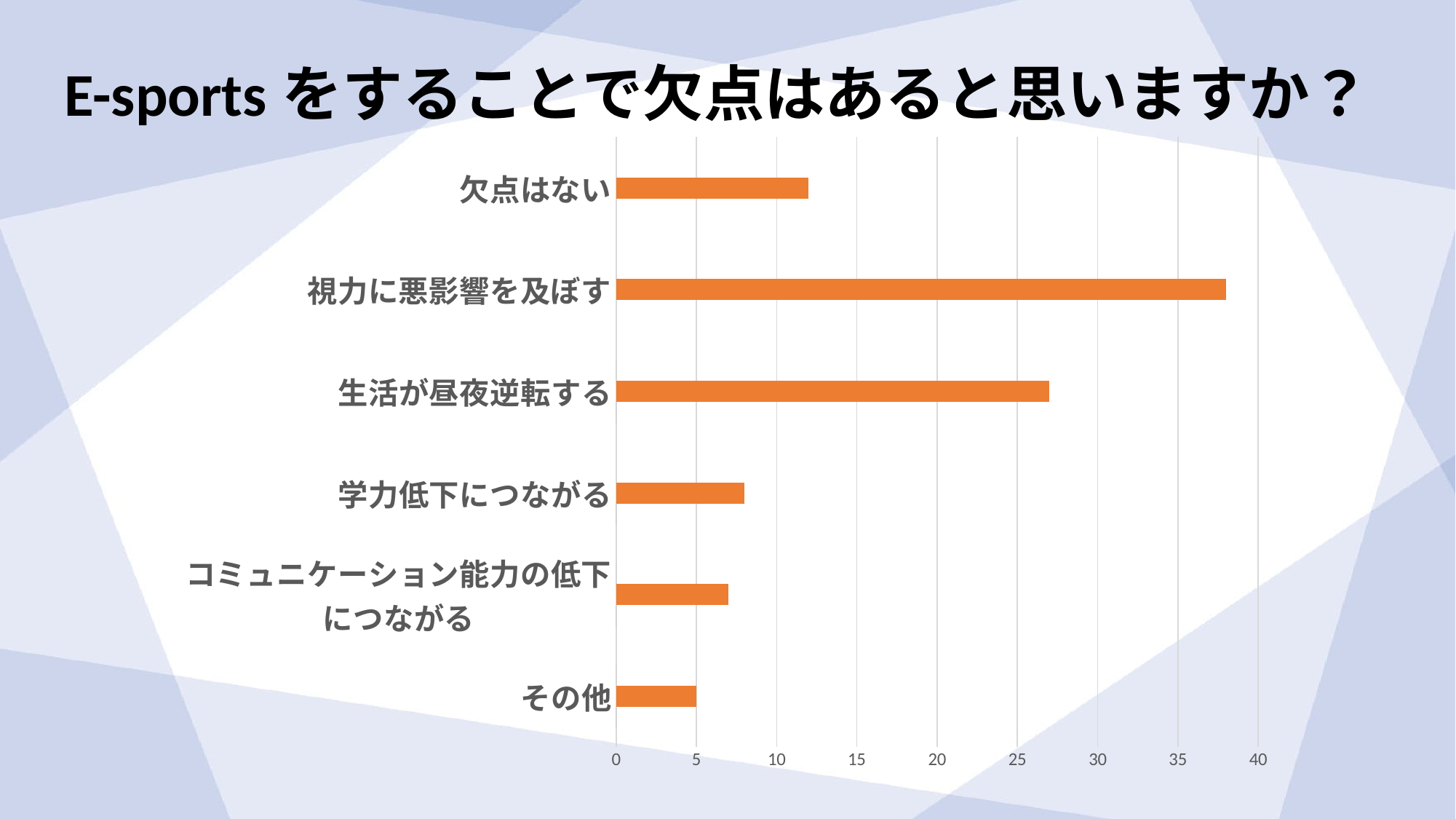
What kind of chart is shown on the slide? bar chart What is the title of the slide? E-sports をすることで欠点はあると思いますか？ Which category has the highest value? 視力に悪影響を及ぼす Which category has the lowest value? その他 Is the value for 欠点はない greater or less than 10? greater Is the value for 生活が昼夜逆転する greater or less than 25? greater Is the value for 視力に悪影響を及ぼす greater or less than 35? greater What is the value for その他? 5 Which is larger, the value for 生活が昼夜逆転する or the value for 欠点はない? 生活が昼夜逆転する How many categories are plotted in the chart? 6